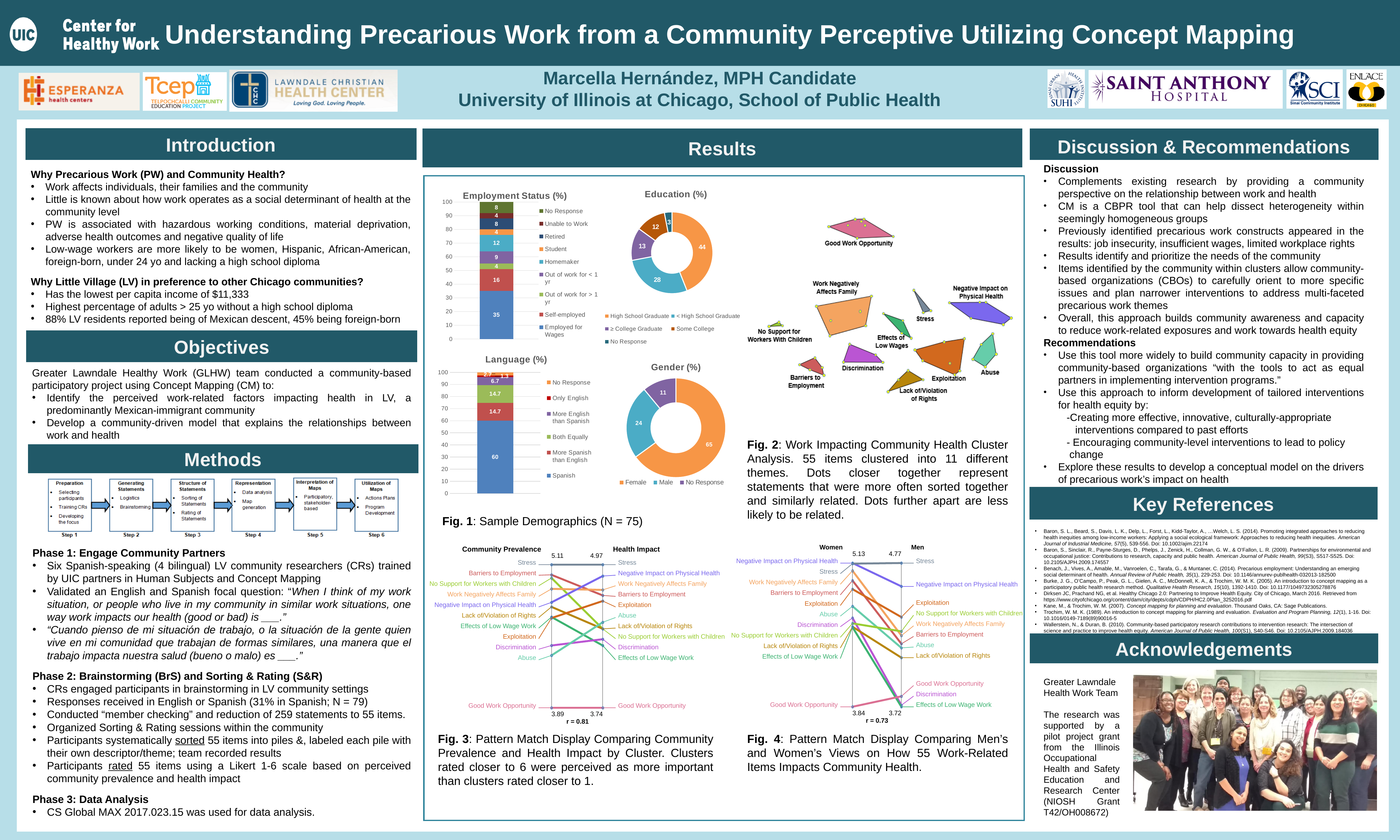
What kind of chart is the Education (%) chart? Donut (pie) chart In the Employment Status (%) chart, what is the value for Employed for Wages? 35 In the Language (%) chart, what is the value for Spanish? 60 In the Language (%) chart, which is larger, Both Equally or More English than Spanish? Both Equally In the Education (%) chart, what is the value for High School Graduate? 44 How many series does the legend of the Employment Status (%) chart list? 9 What kind of chart is the Employment Status (%) chart? Stacked bar chart In the Employment Status (%) chart, what is the difference between Self-employed and Homemaker? 4 In the Employment Status (%) chart, which category has the largest value? Employed for Wages In the Gender (%) chart, what is the value for Male? 24 In the Gender (%) chart, what is the difference between Female and Male? 41 In the Education (%) chart, which category has the smallest value? No Response